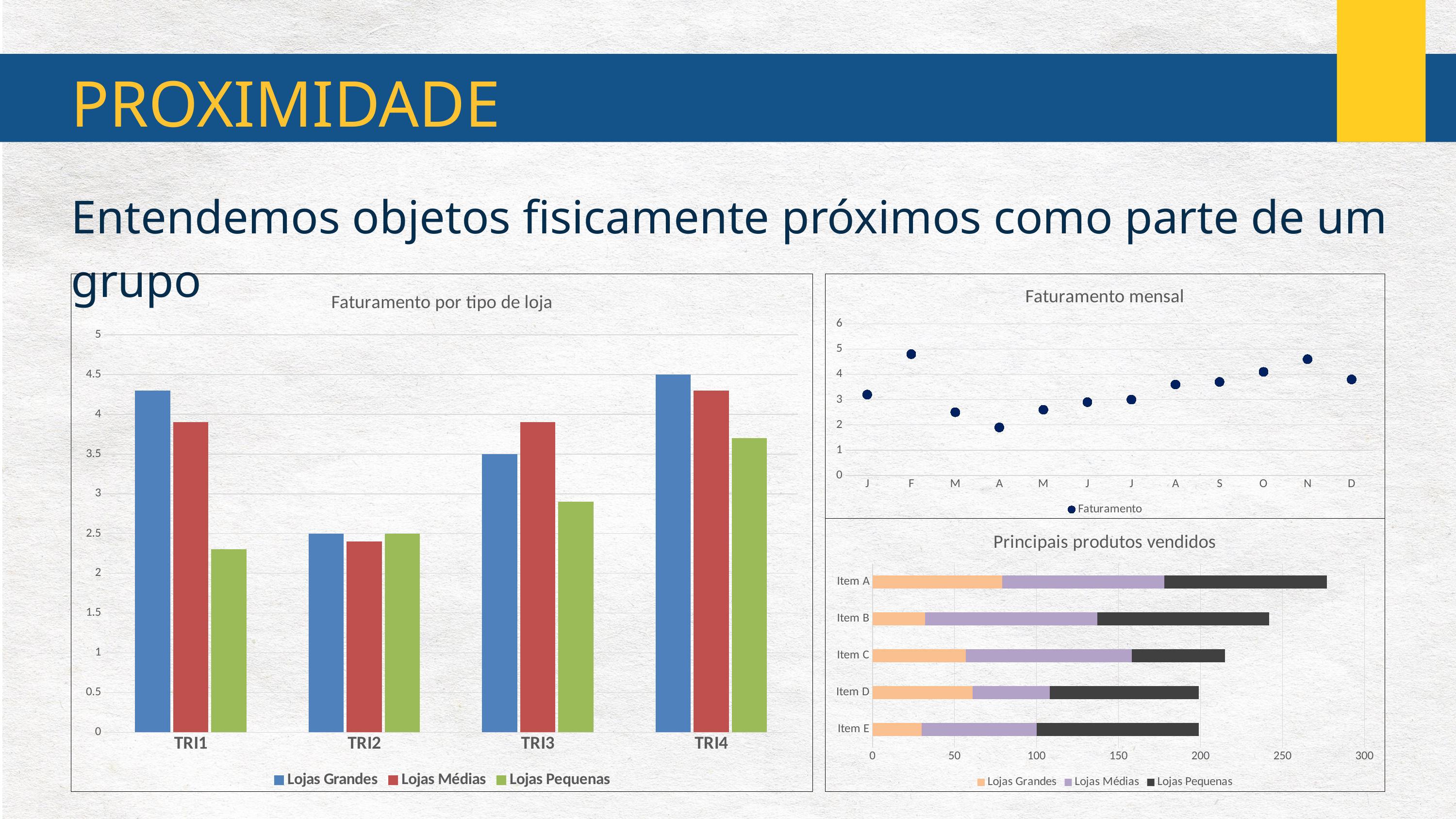
In the 'Faturamento mensal' chart, which month has the lowest value? A (April) In the 'Faturamento mensal' chart, is the value for F greater or less than 4? greater In the 'Faturamento por tipo de loja' chart, what kind of chart is it? bar chart In the 'Principais produtos vendidos' chart, is the total for Item A greater or less than 250? greater In the 'Faturamento por tipo de loja' chart, how many categories are shown on the x axis? 4 In the 'Faturamento mensal' chart, how many data points are plotted? 12 In the 'Faturamento por tipo de loja' chart, which is larger in TRI3: Lojas Grandes or Lojas Médias? Lojas Médias In the 'Principais produtos vendidos' chart, which item has the longest total bar? Item A In the 'Faturamento por tipo de loja' chart, is the value for Lojas Pequenas in TRI1 greater or less than 2.5? less In the 'Principais produtos vendidos' chart, how many items are listed? 5 In the 'Faturamento por tipo de loja' chart, how many series does the legend list? 3